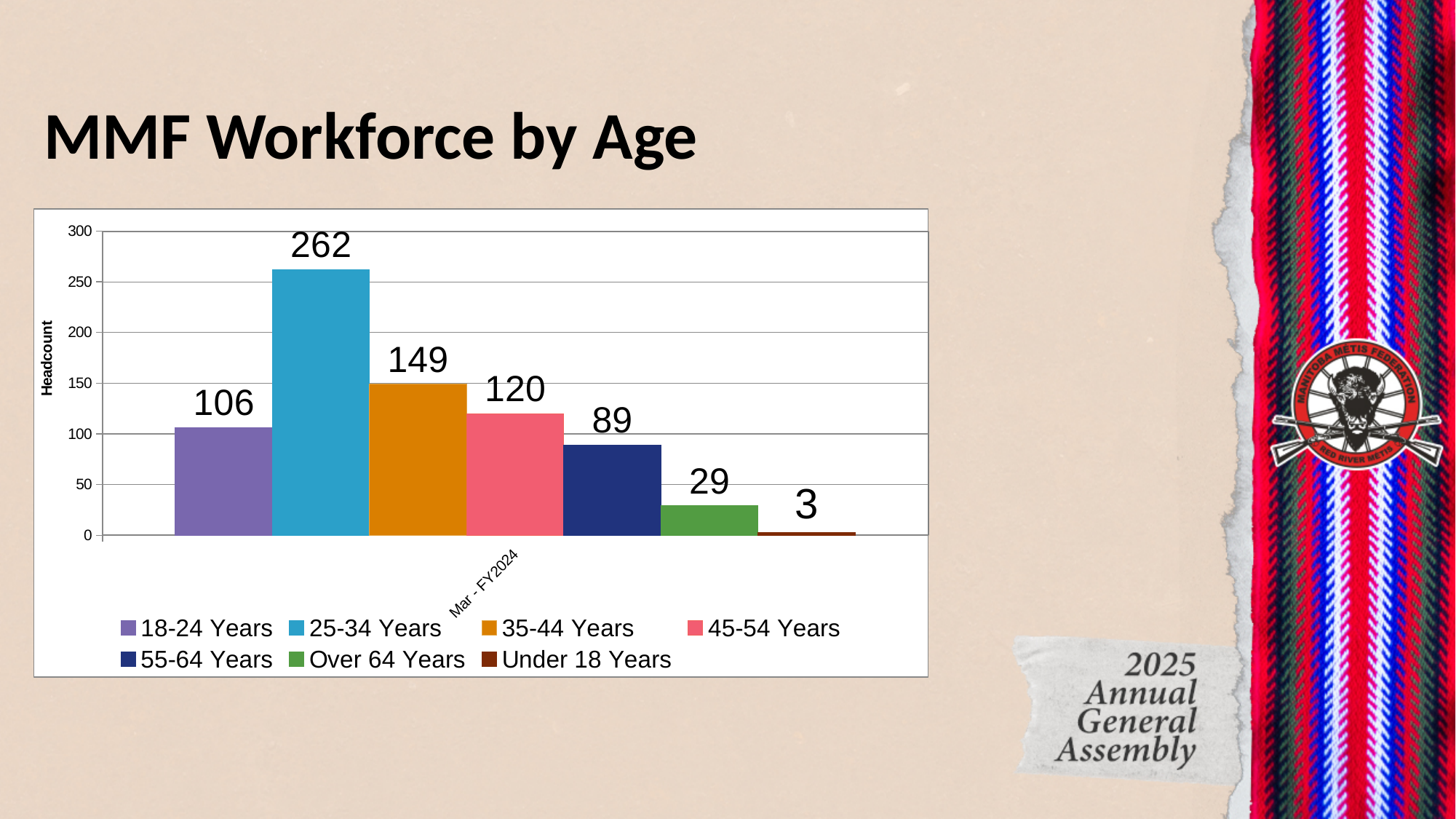
What is the difference in headcount between the 35-44 Years and 55-64 Years groups? 60 Which has a larger headcount, 18-24 Years or 45-54 Years? 45-54 Years What is the headcount for the 25-34 Years series? 262 What is the label on the vertical axis? Headcount Which age group has the lowest headcount? Under 18 Years What is the category label on the x axis? Mar - FY2024 How many series does the legend list? 7 What is the headcount for the Under 18 Years series? 3 What kind of chart is shown on the slide? bar chart Which age group has the highest headcount? 25-34 Years Is the headcount for the Over 64 Years group greater or less than 50? less What is the headcount for the 45-54 Years series? 120